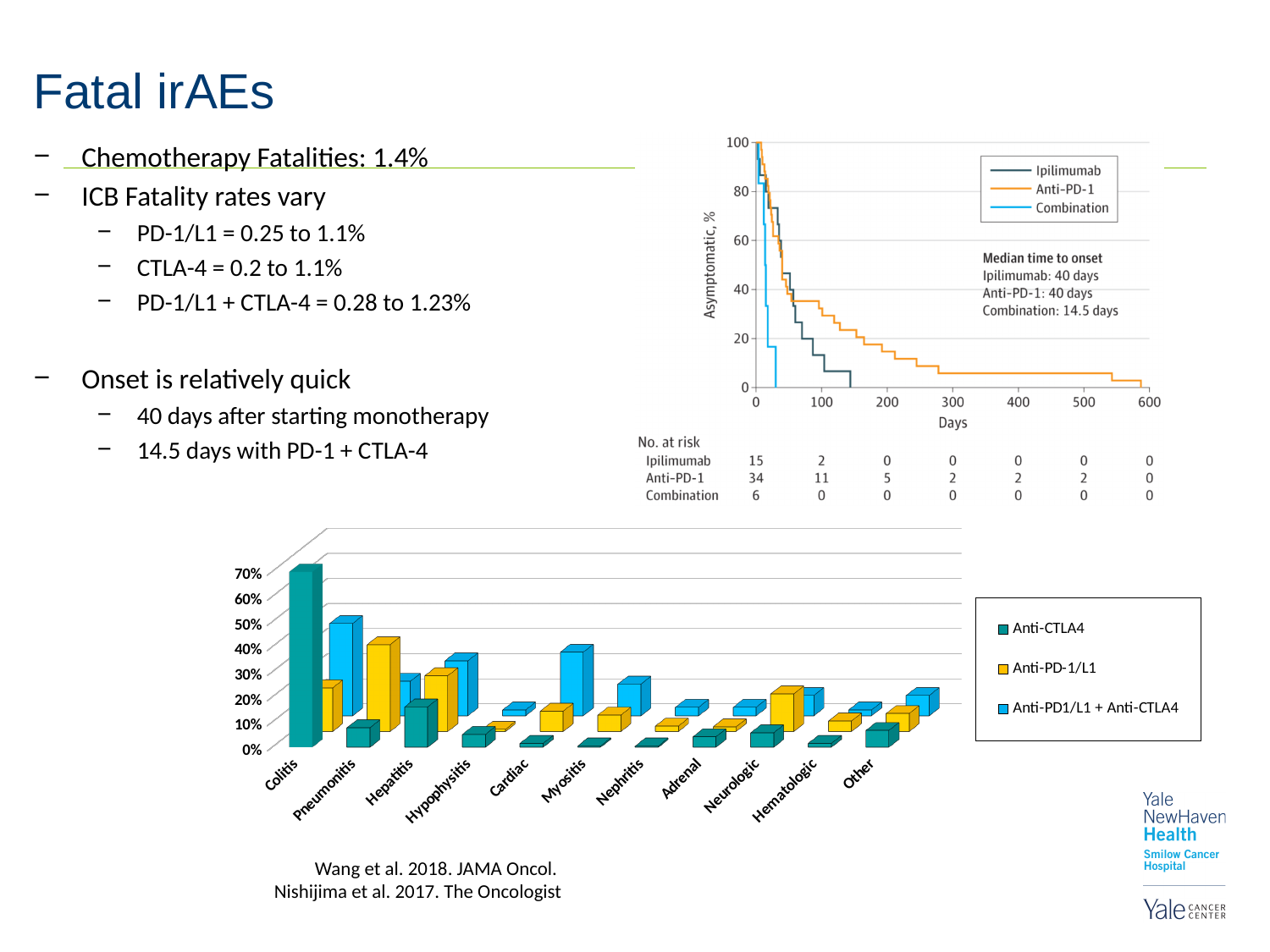
In the bottom bar chart, is the Anti-CTLA4 value for Colitis greater or less than 60%? greater How many series does the legend of the bottom bar chart list? 3 How many categories are shown on the x axis of the bottom bar chart? 11 In the top-right line chart, what is the median time to onset for the Combination group? 14.5 days In the bottom bar chart, which category has the highest Anti-CTLA4 value? Colitis In the top-right line chart's 'No. at risk' table, how many Anti-PD-1 patients are at risk at day 0? 34 In the bottom bar chart, which category has the highest Anti-PD-1/L1 value? Pneumonitis What kind of chart is the top-right chart with the y axis labelled 'Asymptomatic, %'? line chart In the bottom bar chart, which is larger for Colitis: the Anti-CTLA4 value or the Anti-PD-1/L1 value? Anti-CTLA4 What kind of chart is the bottom chart showing irAE types such as Colitis and Pneumonitis? bar chart How many series does the legend of the top-right line chart list? 3